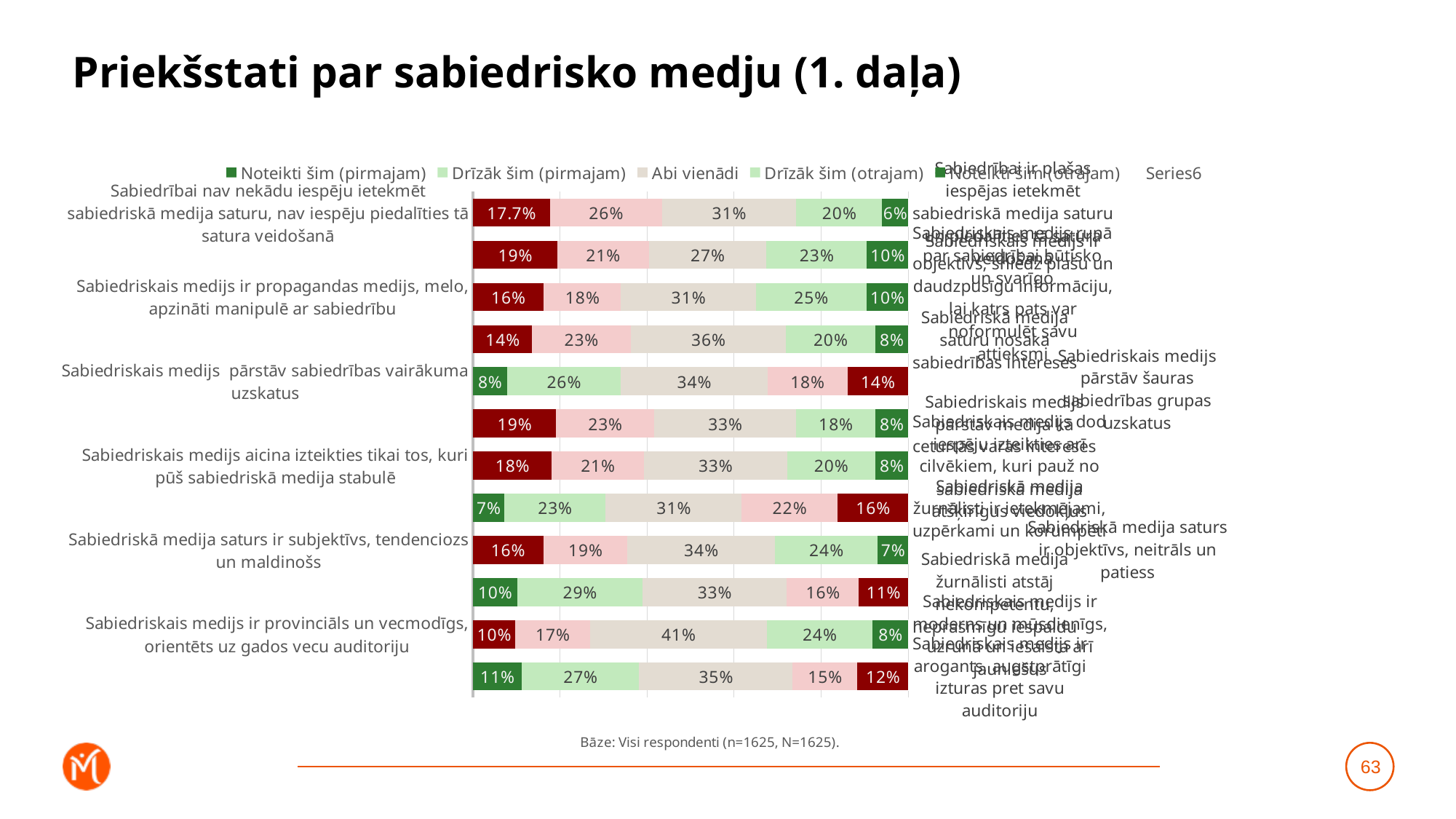
What is the title of the slide? Priekšstati par sabiedrisko medju (1. daļa) In the top bar, what is the value of the last (rightmost) segment? 6% What kind of chart is shown on the slide? Stacked bar chart In the bottom bar, what is the value of the middle segment? 35% In the top bar, what is the value of the middle "Abi vienādi" segment? 31% What is the largest middle ("Abi vienādi") segment value shown in any bar? 41% In the fourth bar from the top, what is the value of the middle segment? 36% How many series does the legend list? 6 In the top bar, which is larger: the second segment or the fourth segment? The second segment (26%) In the top bar, what is the difference between the middle segment (31%) and the second segment (26%)? 5 percentage points In the top bar ("Sabiedrībai nav nekādu iespēju ietekmēt sabiedriskā medija saturu..."), what is the value of the first (leftmost) segment? 17.7% How many bars (statements) does the chart contain? 12